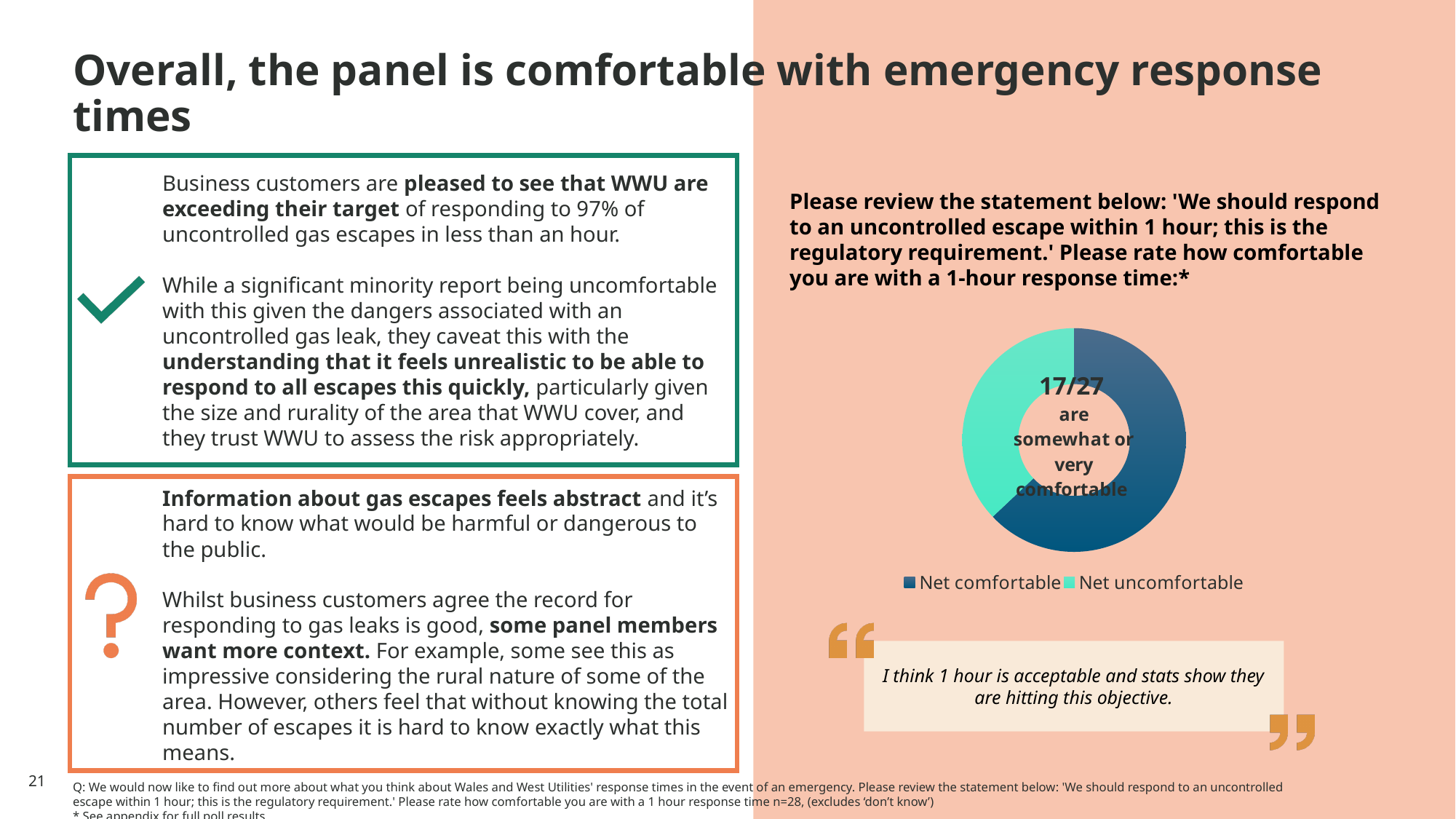
How many entries does the chart legend list? 2 Which category takes up the smaller share of the doughnut chart? Net uncomfortable How many categories does the doughnut chart show? 2 Is the Net comfortable segment larger or smaller than the Net uncomfortable segment? larger According to the text in the centre of the chart, how many of the 27 panel members are somewhat or very comfortable? 17 What are the two legend entries of the chart? Net comfortable, Net uncomfortable Which colour represents Net uncomfortable in the chart? light teal/green What fraction is printed in the centre of the doughnut chart? 17/27 What kind of chart is shown on the slide? doughnut chart Which category takes up the larger share of the doughnut chart? Net comfortable